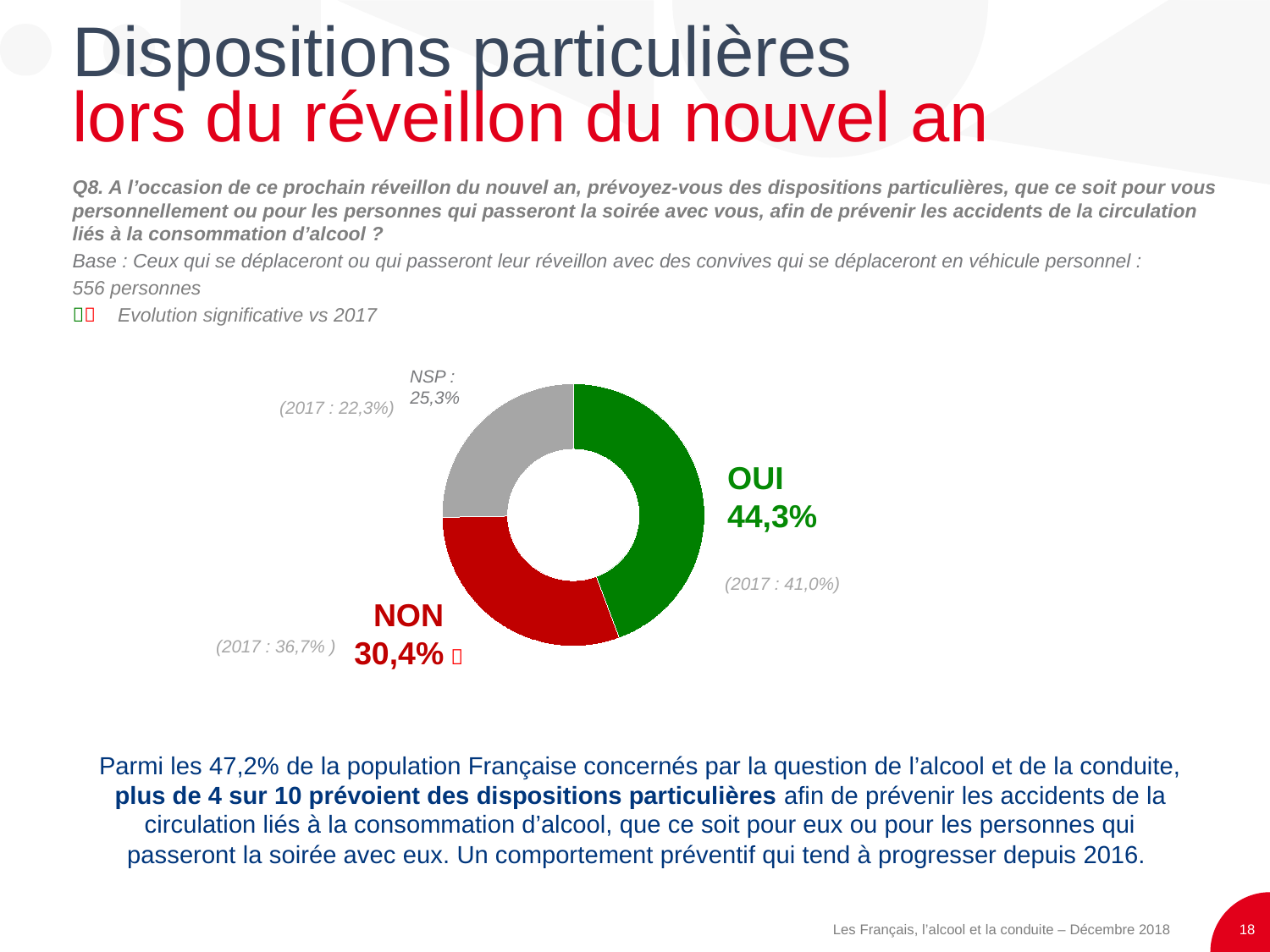
What was the 2017 value shown for OUI next to the pie chart? 41,0% What is the value shown for NSP in the pie chart? 25,3% What kind of chart is shown on the slide? Pie chart (donut) What colour is the OUI slice in the pie chart? Green Which slice of the pie chart is the largest? OUI What is the value shown for NON in the pie chart? 30,4% Which slice of the pie chart is the smallest? NSP What is the difference between the OUI and NON values in the pie chart? 13,9 points How many slices does the pie chart have? 3 What is the value shown for OUI in the pie chart? 44,3% What was the 2017 value shown for NON next to the pie chart? 36,7% Which is larger in the pie chart, NON or NSP? NON